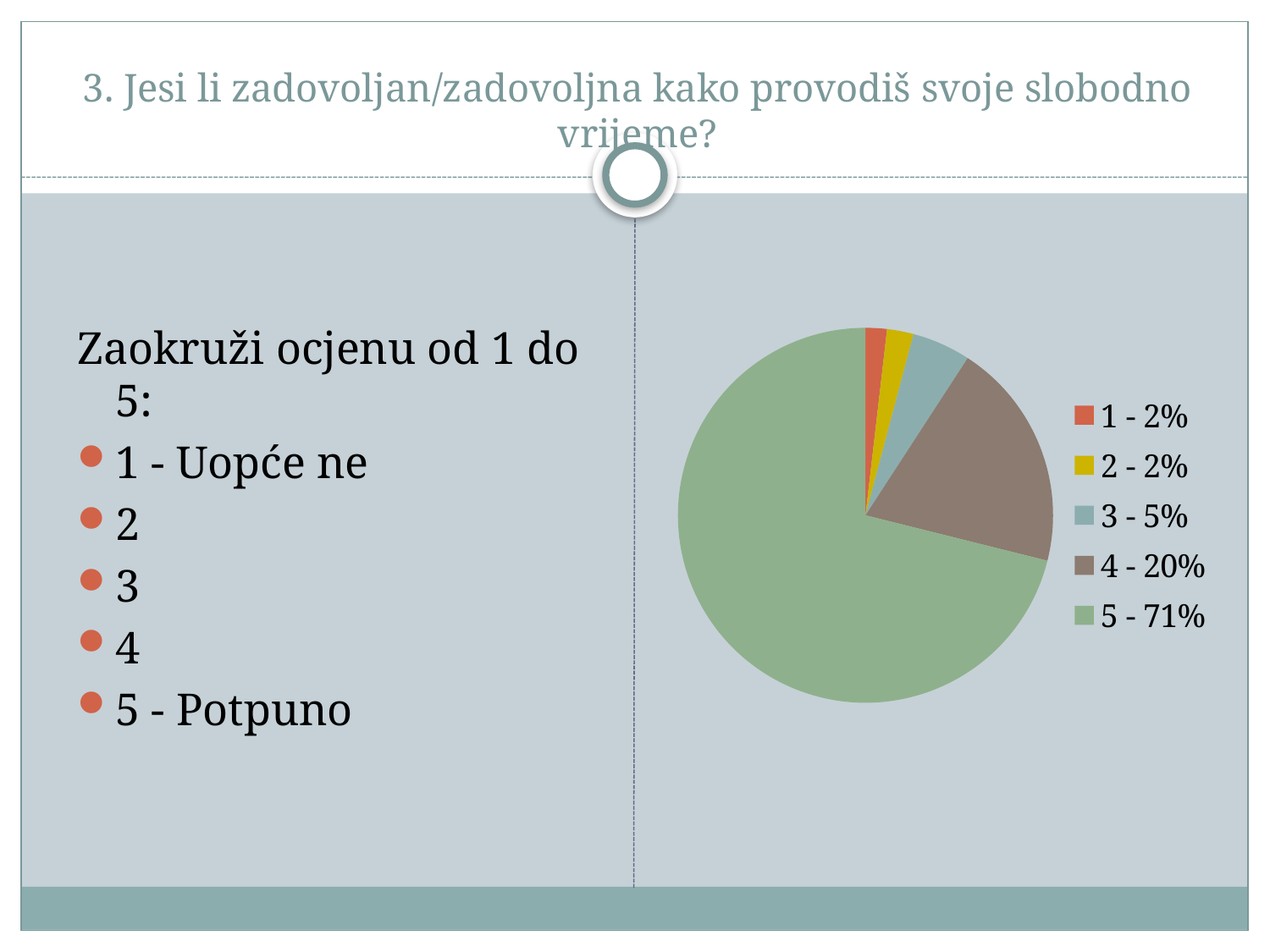
How many slices does the pie chart have? 5 What kind of chart is shown on the slide? pie chart What share of the pie does rating 5 have? 71% What share of the pie does rating 3 have? 5% Which rating has the larger share, 3 or 4? 4 What share of the pie does rating 4 have? 20% What colour is the slice for rating 5? green What is the combined share of ratings 1, 2 and 3? 9% How many entries does the legend list? 5 What is the difference in percentage points between the shares for rating 5 and rating 4? 51 Which rating has the largest slice of the pie? 5